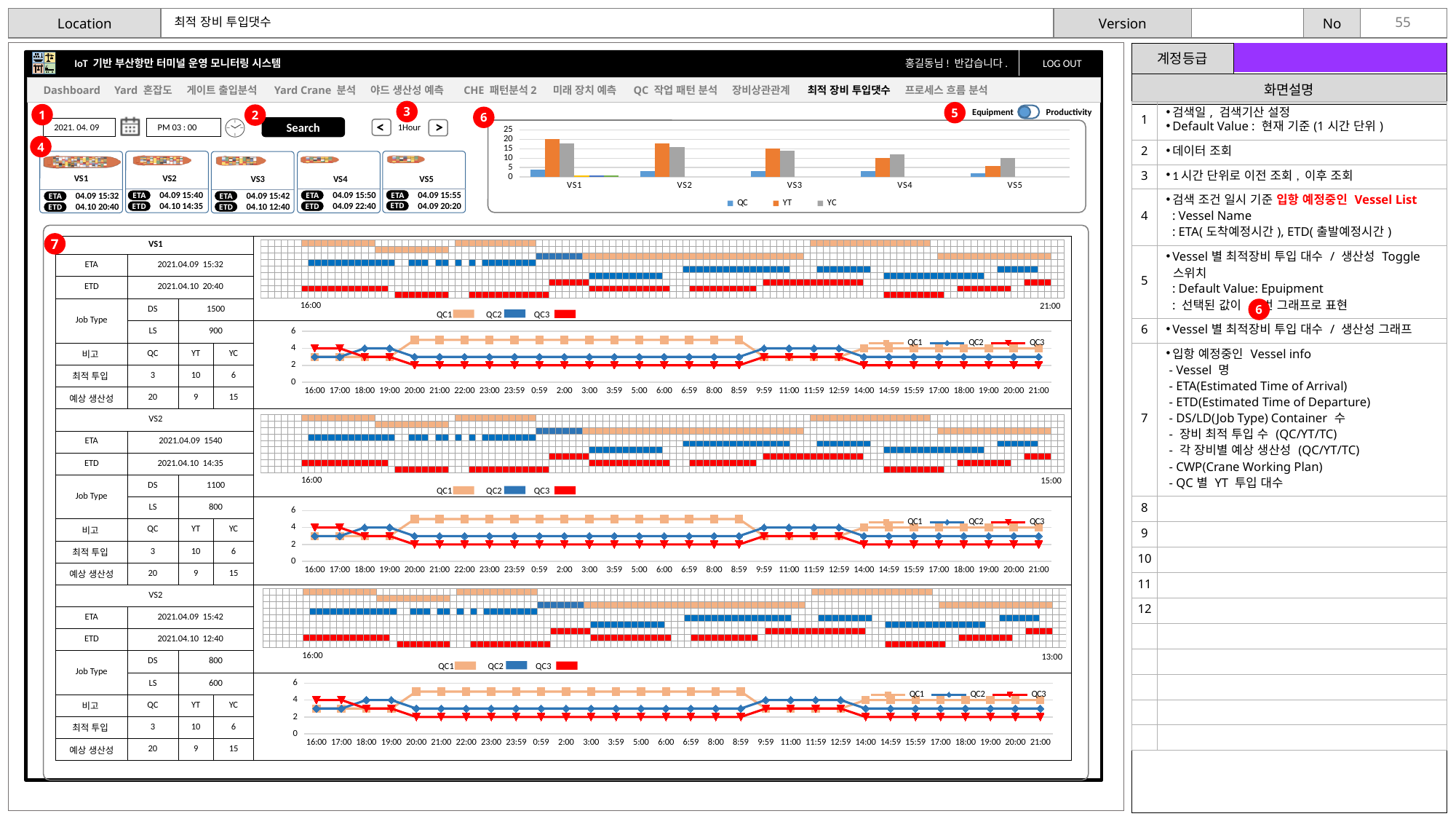
In the bar chart at the top of the slide, do the YT values rise or fall from VS1 to VS5? fall In the bar chart at the top of the slide, is the YT value for VS1 greater or less than 15? greater In the bar chart at the top of the slide, how many series does the legend list? 3 In the bar chart at the top of the slide, what kind of chart is it? bar chart In the first line chart (for VS1), how many series does the legend list? 3 In the bar chart at the top of the slide, for VS5, which is larger: YT or YC? YC In the bar chart at the top of the slide, what are the legend entries? QC, YT, YC In the bar chart at the top of the slide, how many vessel categories are shown on the x axis? 5 In the bar chart at the top of the slide, which vessel has the lowest YT value? VS5 In the bar chart at the top of the slide, which vessel has the highest YT value? VS1 In the first line chart (for VS1), is the QC1 value at 20:00 greater or less than 4? greater In the bar chart at the top of the slide, is the QC value for VS3 greater or less than 5? less